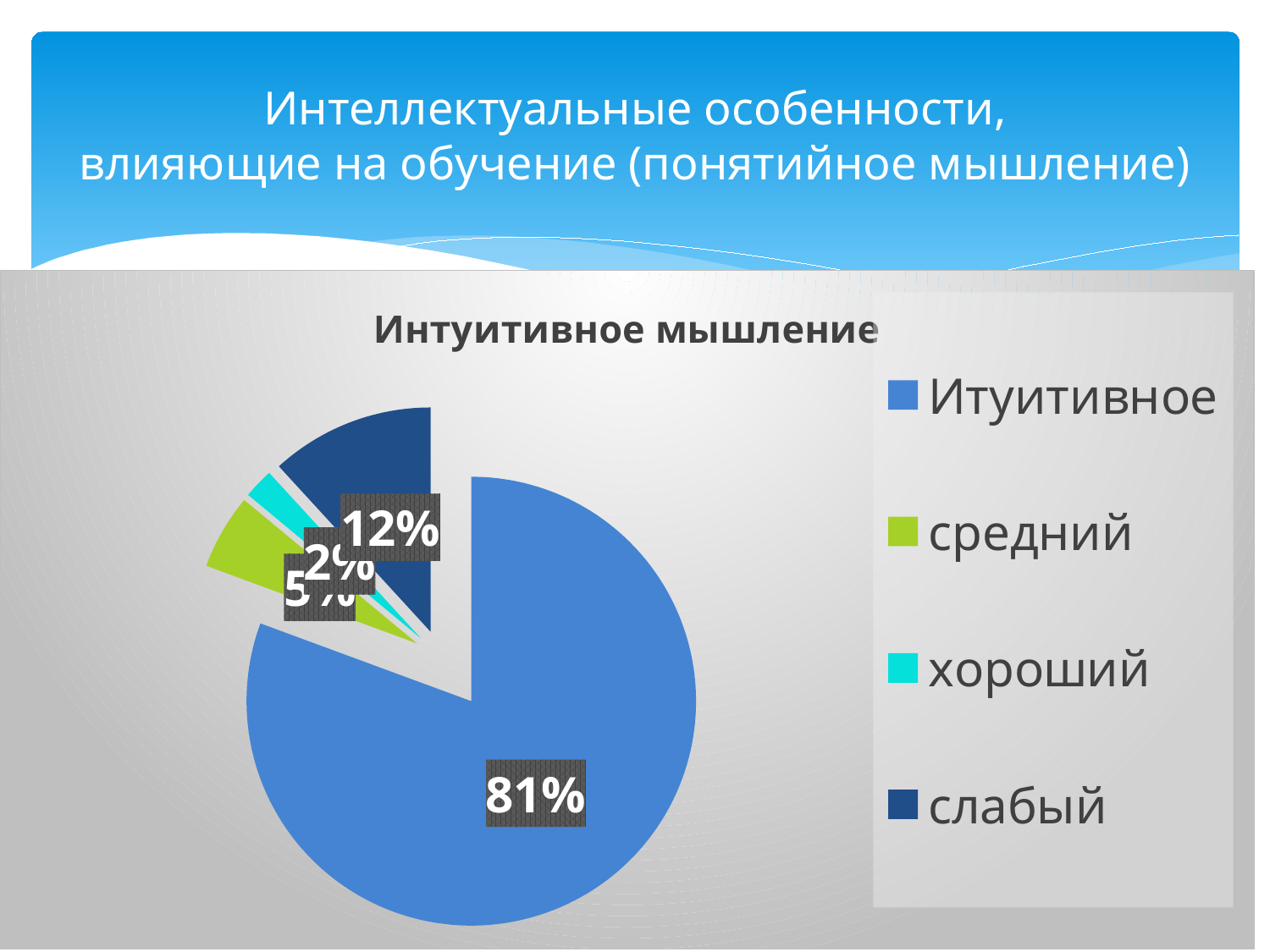
What kind of chart is shown on the slide? pie chart What share of the pie does the 'хороший' slice have? 2% What share of the pie does the 'слабый' slice have? 12% What share of the pie does the 'средний' slice have? 5% What colour is the 'слабый' slice in the pie chart? dark blue What is the difference in percentage points between the 'Итуитивное' slice and the 'слабый' slice? 69 What is the title of the chart? Интуитивное мышление Which category has the smallest slice of the pie? хороший Which category has the largest slice of the pie? Итуитивное How many categories does the legend of the pie chart list? 4 Which slice is larger, 'слабый' or 'средний'? слабый